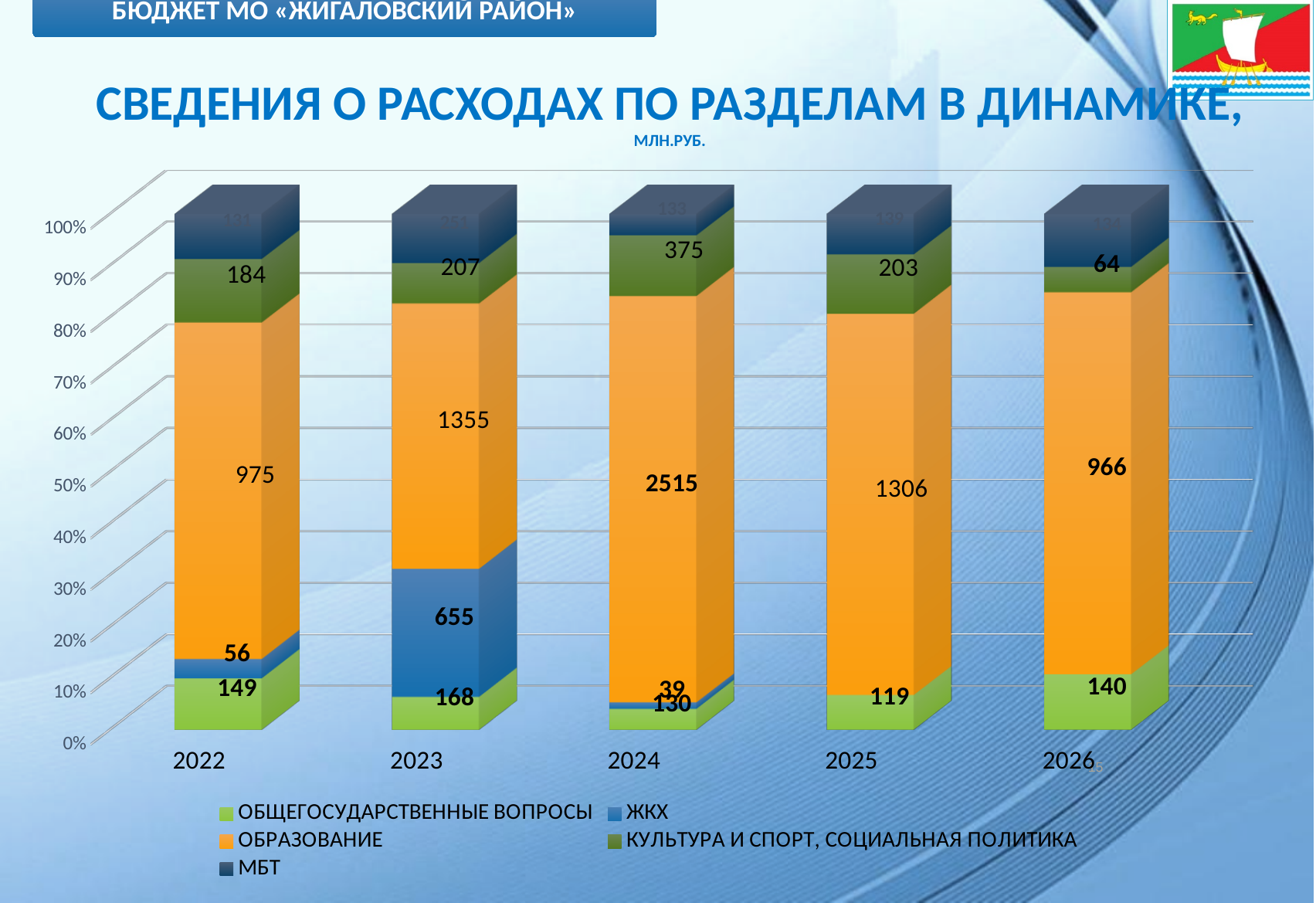
How many years are shown along the x axis? 5 Which year has the larger value for КУЛЬТУРА И СПОРТ, СОЦИАЛЬНАЯ ПОЛИТИКА, 2024 or 2025? 2024 What is the value for КУЛЬТУРА И СПОРТ, СОЦИАЛЬНАЯ ПОЛИТИКА in 2026? 64 In which year is the value for ОБЩЕГОСУДАРСТВЕННЫЕ ВОПРОСЫ the lowest? 2025 What is the difference between the ОБРАЗОВАНИЕ values for 2023 and 2022? 380 What is the value for ОБРАЗОВАНИЕ in 2024? 2515 What is the value for ОБЩЕГОСУДАРСТВЕННЫЕ ВОПРОСЫ in 2026? 140 How many series does the legend list? 5 In what units are the values on the chart given, according to the subtitle? МЛН.РУБ. What is the value for ЖКХ in 2023? 655 In which year is the value for ОБРАЗОВАНИЕ the highest? 2024 What kind of chart is shown on the slide? Stacked bar chart